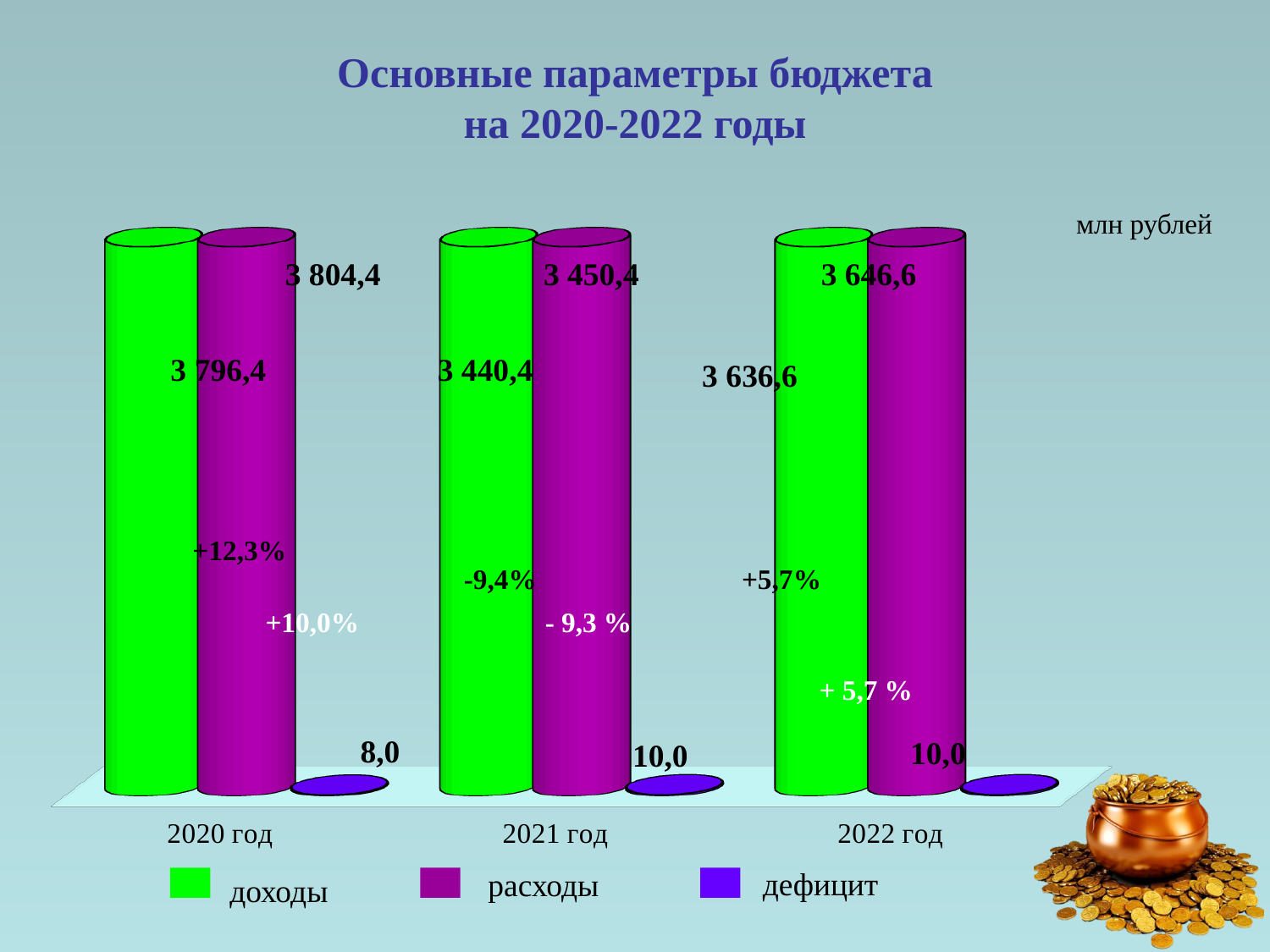
Which is larger in 2022 год: доходы or расходы? расходы What is the value of доходы for 2020 год? 3 796,4 What is the difference between расходы and доходы in 2020 год? 8,0 What is the value of расходы for 2022 год? 3 646,6 What unit is stated for the values on the chart? млн рублей How many series does the legend list? 3 What is the value of расходы for 2021 год? 3 450,4 What is the value of дефицит for 2022 год? 10,0 How many years are shown on the x axis? 3 In which year is расходы the lowest? 2021 год What is the difference between доходы in 2020 год and доходы in 2021 год? 356,0 In which year is доходы the highest? 2020 год